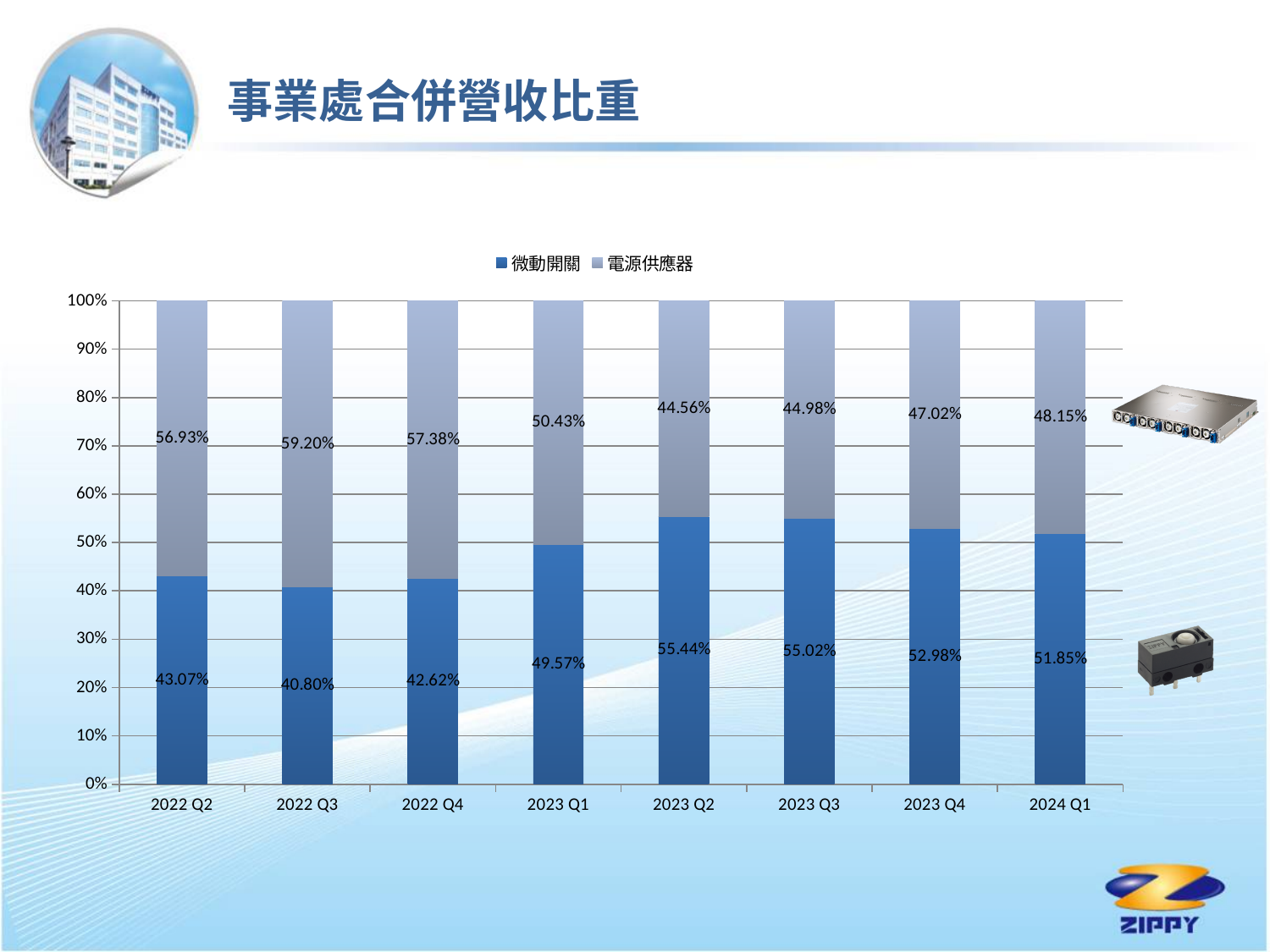
What is the difference between the 電源供應器 and 微動開關 shares in 2022 Q2? 13.86% In which quarter is the 微動開關 share lowest? 2022 Q3 Which is larger in 2023 Q4, 微動開關 or 電源供應器? 微動開關 What is the value for 電源供應器 in 2022 Q3? 59.20% What kind of chart is shown on the slide? Stacked bar chart In which quarter is the 電源供應器 share highest? 2022 Q3 How many quarters are shown on the x axis? 8 In which quarter is the 微動開關 share highest? 2023 Q2 What is the total of the stacked bar for 2023 Q1? 100% How many series does the legend list? 2 What is the value for 微動開關 in 2024 Q1? 51.85% What is the value for 微動開關 in 2023 Q2? 55.44%